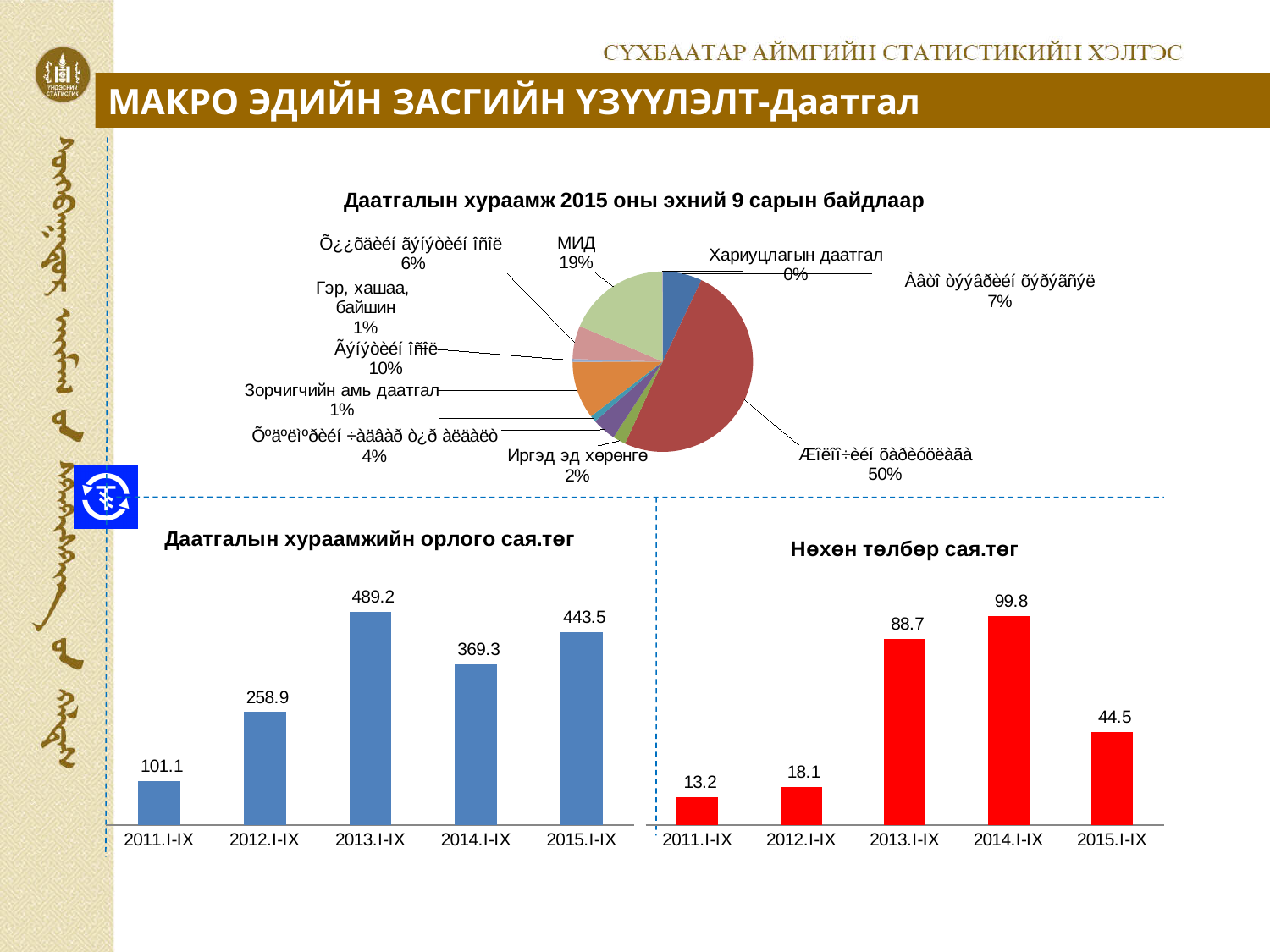
In the pie chart titled "Даатгалын хураамж 2015 оны эхний 9 сарын байдлаар", what share does МИД have? 19% In the chart titled "Даатгалын хураамжийн орлого сая.төг", how many periods are shown on the x axis? 5 In the chart titled "Даатгалын хураамжийн орлого сая.төг", which period has the lowest value? 2011.I-IX In the chart titled "Даатгалын хураамжийн орлого сая.төг", what is the difference between the values for 2015.I-IX and 2014.I-IX? 74.2 In the chart titled "Нөхөн төлбөр сая.төг", which period has the highest value? 2014.I-IX In the chart titled "Нөхөн төлбөр сая.төг", which is larger, the value for 2013.I-IX or 2015.I-IX? 2013.I-IX In the chart titled "Нөхөн төлбөр сая.төг", what is the value for 2014.I-IX? 99.8 In the chart titled "Даатгалын хураамжийн орлого сая.төг", what is the value for 2013.I-IX? 489.2 In the pie chart titled "Даатгалын хураамж 2015 оны эхний 9 сарын байдлаар", what share does Иргэд эд хөрөнгө have? 2% In the chart titled "Нөхөн төлбөр сая.төг", what is the difference between the values for 2012.I-IX and 2011.I-IX? 4.9 What kind of chart is the one titled "Нөхөн төлбөр сая.төг"? Bar chart What colour are the bars in the chart titled "Даатгалын хураамжийн орлого сая.төг"? Blue